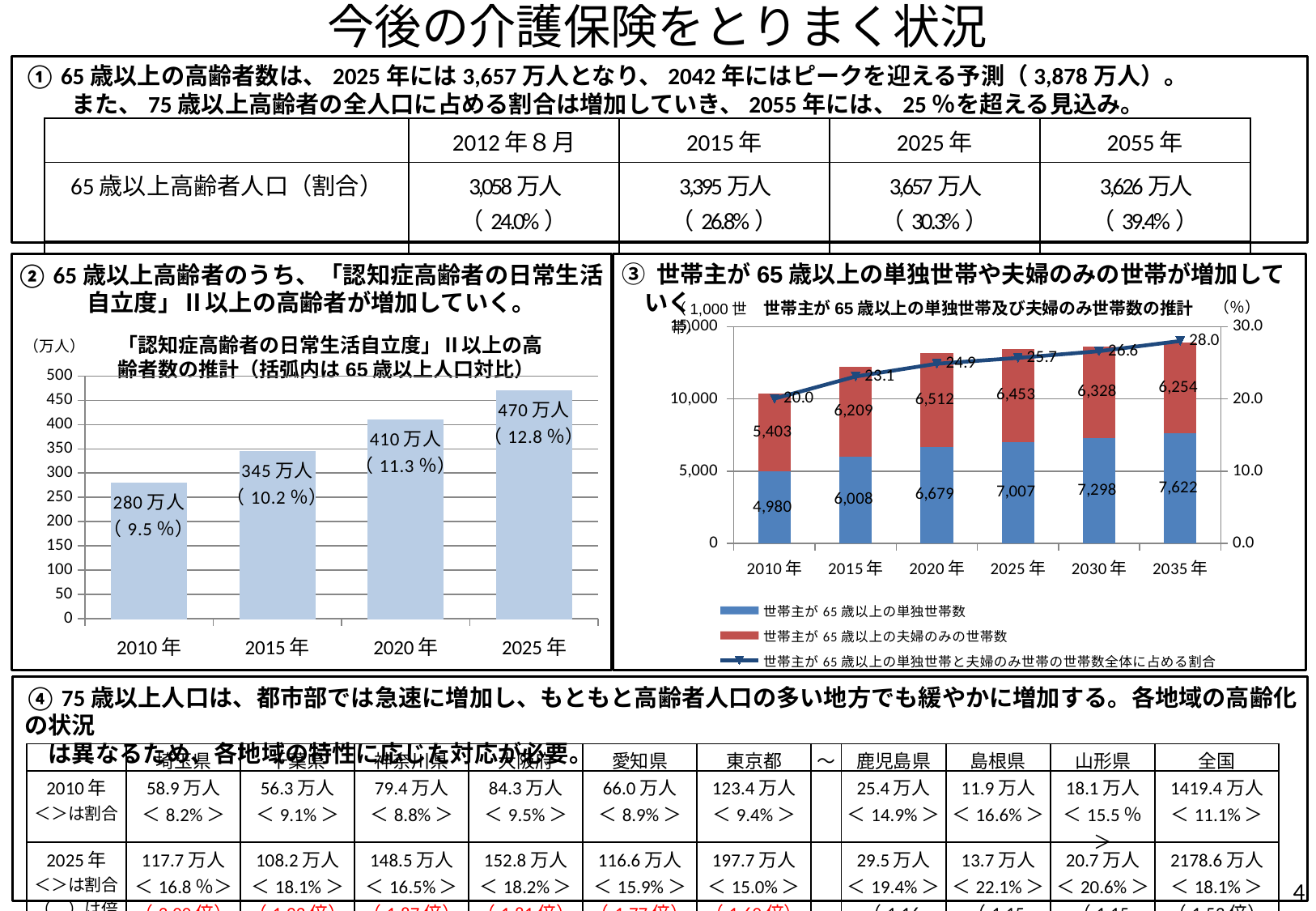
In the right chart, what is the total of the stacked bar for 2035年? 13,876 In the left chart, what is the difference between the 2025年 and 2010年 values? 190万人 In the left chart, what percentage is shown in parentheses for 2025年? 12.8% In the left chart (認知症高齢者の日常生活自立度 Ⅱ以上の高齢者数の推計), what is the value for 2015年? 345万人 How many series does the legend of the right chart list? 3 In the left chart, do the values rise or fall from 2010年 to 2025年? rise In the right chart, what is the value for 世帯主が65歳以上の夫婦のみの世帯数 in 2010年? 5,403 How many bars are in the left chart? 4 In the right chart, what is the line value (割合) for 2025年? 25.7 In the right chart (世帯主が65歳以上の単独世帯及び夫婦のみ世帯数の推計), what is the value for 世帯主が65歳以上の単独世帯数 in 2020年? 6,679 In the right chart, which year has the lowest value for 世帯主が65歳以上の単独世帯数? 2010年 In the left chart, which year has the highest value? 2025年